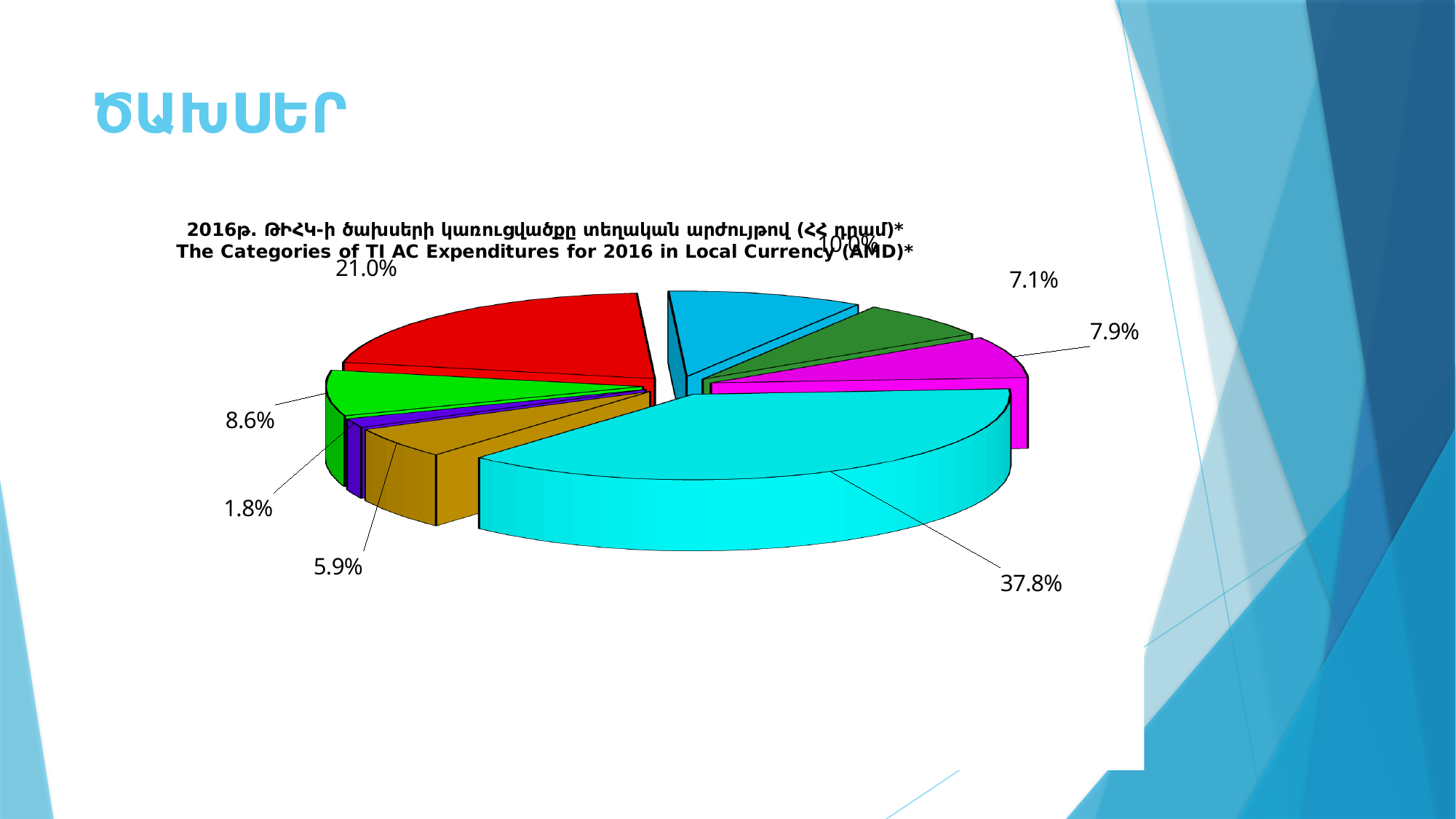
What kind of chart is shown on the slide? Pie chart What is the English title of the pie chart? The Categories of TI AC Expenditures for 2016 in Local Currency (AMD)* What share does the magenta slice of the pie chart represent? 7.9% Which slice is larger: the red slice or the bright green slice? The red slice What is the share of the largest slice in the pie chart? 37.8% What is the difference in percentage points between the largest slice (37.8%) and the red slice (21.0%)? 16.8 How many slices does the pie chart have? 8 What share does the red slice of the pie chart represent? 21.0% What colour is the largest slice of the pie chart? Cyan What share does the brown (gold) slice of the pie chart represent? 5.9% What is the share of the smallest slice in the pie chart? 1.8%